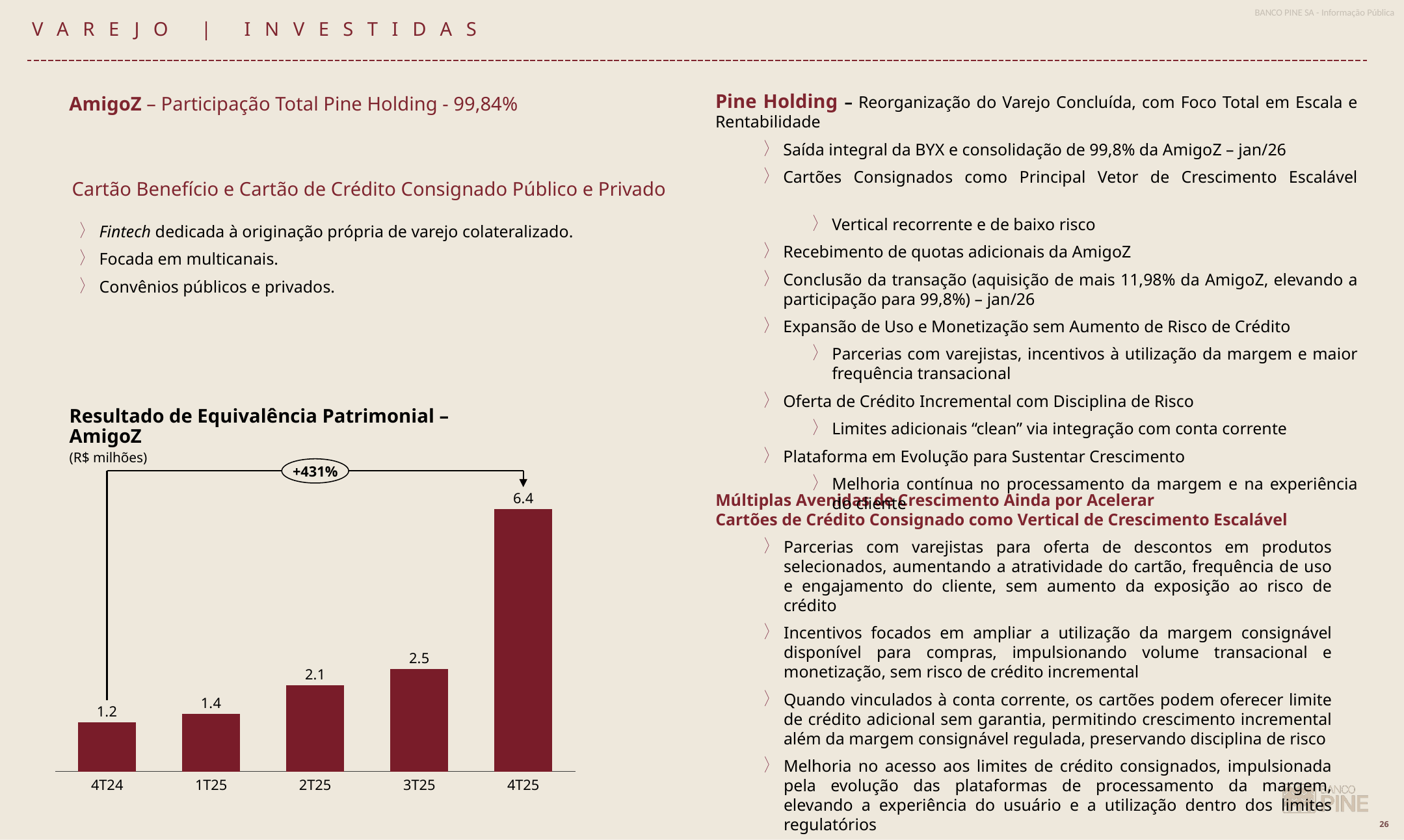
Which quarter has the lowest value in the 'Resultado de Equivalência Patrimonial – AmigoZ' chart? 4T24 What is the value for 2T25 in the 'Resultado de Equivalência Patrimonial – AmigoZ' chart? 2.1 What kind of chart is the 'Resultado de Equivalência Patrimonial – AmigoZ' chart? Bar chart Do the values in the 'Resultado de Equivalência Patrimonial – AmigoZ' chart rise or fall from 4T24 to 4T25? Rise What percentage change is annotated between 4T24 and 4T25 in the 'Resultado de Equivalência Patrimonial – AmigoZ' chart? +431% What is the difference between the 1T25 and 4T24 values in the 'Resultado de Equivalência Patrimonial – AmigoZ' chart? 0.2 What is the value for 4T24 in the 'Resultado de Equivalência Patrimonial – AmigoZ' chart? 1.2 What is the value for 4T25 in the 'Resultado de Equivalência Patrimonial – AmigoZ' chart? 6.4 In the 'Resultado de Equivalência Patrimonial – AmigoZ' chart, which is larger: the value for 3T25 or the value for 2T25? 3T25 How many quarters are shown in the 'Resultado de Equivalência Patrimonial – AmigoZ' chart? 5 Which quarter has the highest value in the 'Resultado de Equivalência Patrimonial – AmigoZ' chart? 4T25 What is the difference between the 4T25 and 3T25 values in the 'Resultado de Equivalência Patrimonial – AmigoZ' chart? 3.9